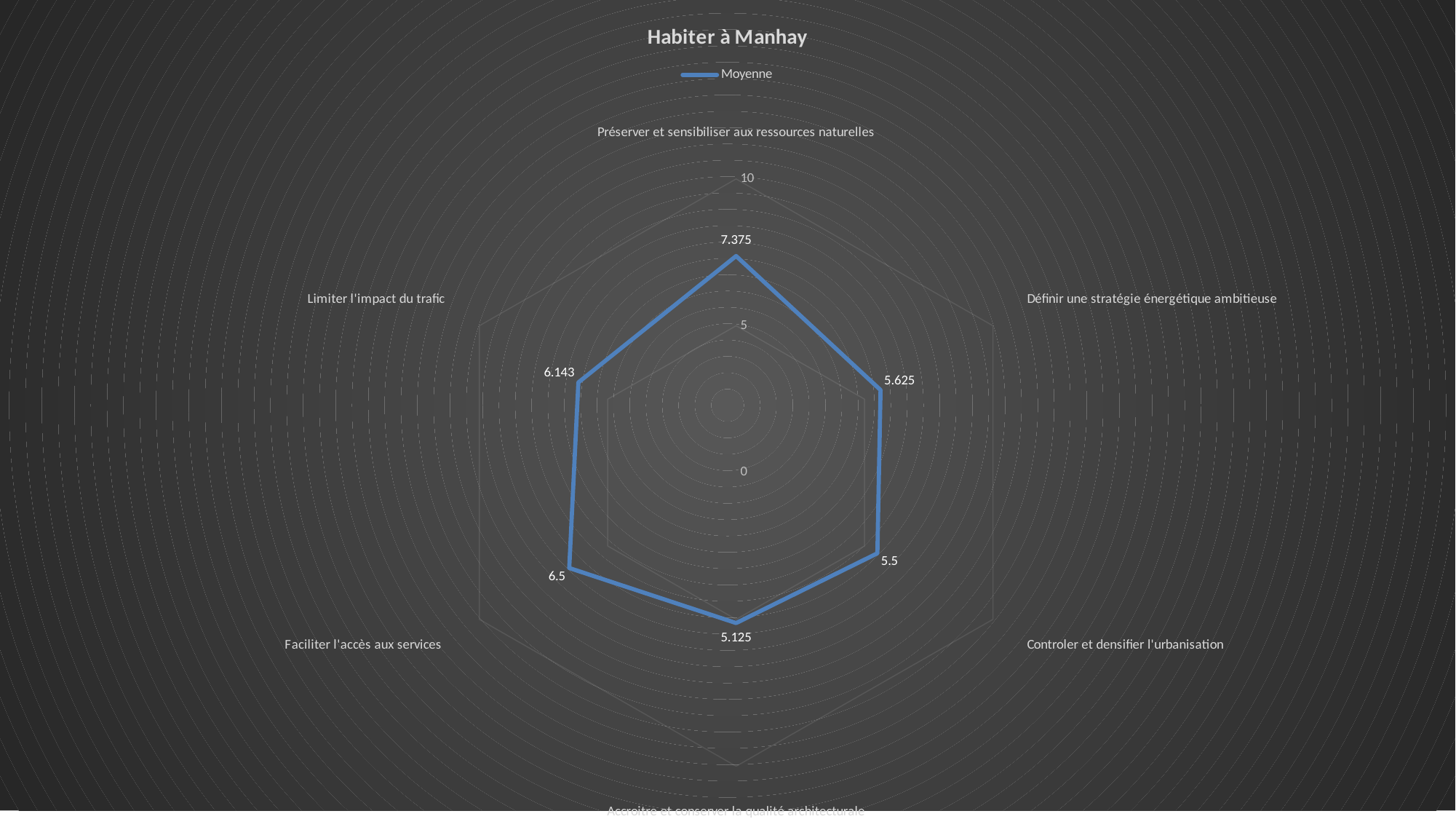
What is the name of the series shown in the legend? Moyenne How many categories (axes) does the radar chart have? 6 Which category has the highest value? Préserver et sensibiliser aux ressources naturelles What kind of chart is shown on the slide? Radar chart What is the value for 'Faciliter l'accès aux services'? 6.5 Which is larger, the value for 'Faciliter l'accès aux services' or for 'Limiter l'impact du trafic'? Faciliter l'accès aux services What is the value for 'Limiter l'impact du trafic'? 6.143 What is the value for 'Préserver et sensibiliser aux ressources naturelles'? 7.375 What is the value for 'Définir une stratégie énergétique ambitieuse'? 5.625 What is the lowest value plotted on the chart? 5.125 What is the value for 'Controler et densifier l'urbanisation'? 5.5 What is the difference between the values for 'Préserver et sensibiliser aux ressources naturelles' and 'Définir une stratégie énergétique ambitieuse'? 1.75